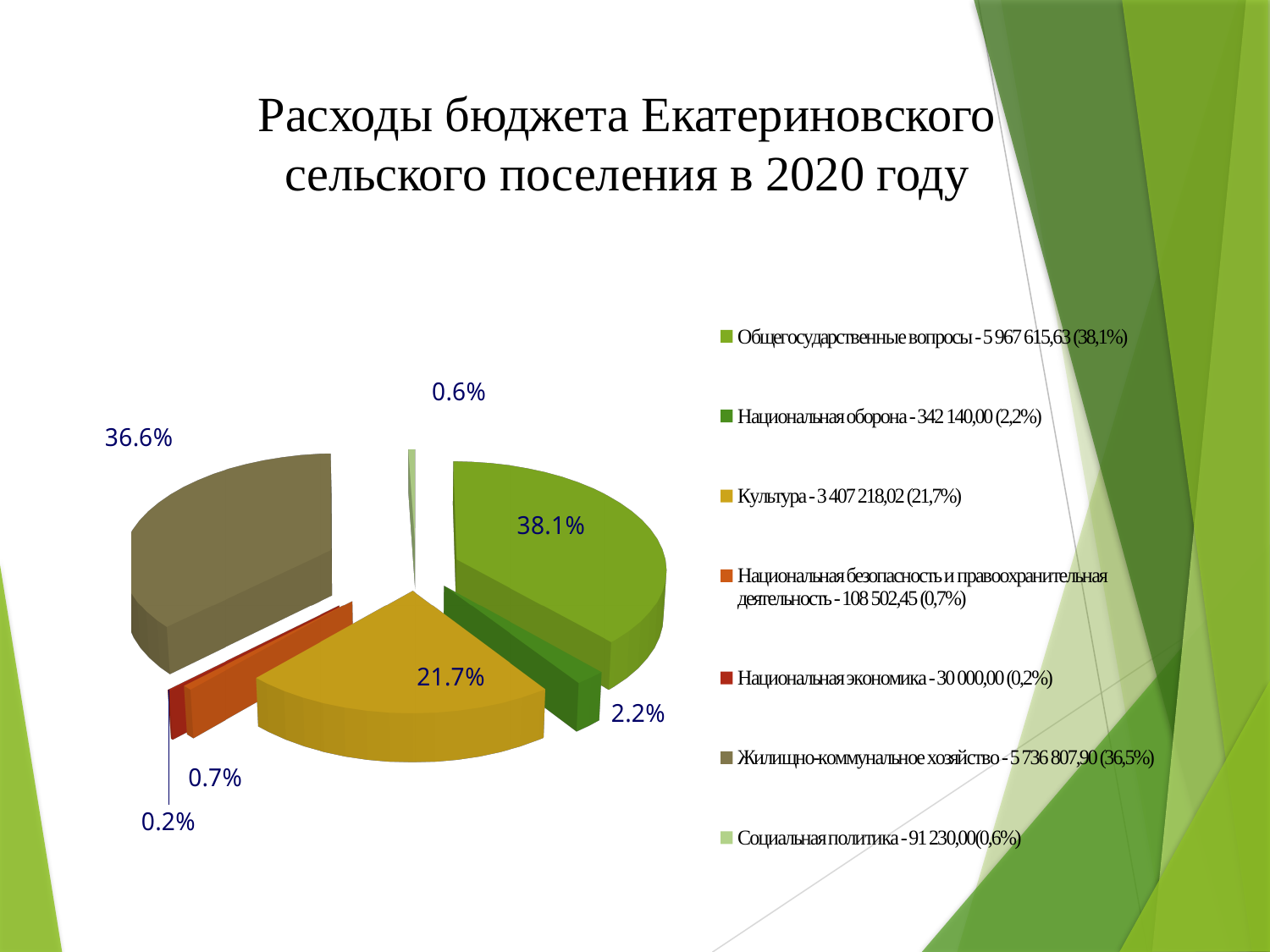
According to the legend, what is the amount for Жилищно-коммунальное хозяйство? 5 736 807,90 How many slices does the pie chart have? 7 What kind of chart is shown on the slide? Pie chart Which category has the smallest slice of the pie? Национальная экономика What is the difference in percentage points between the Общегосударственные вопросы slice (38.1%) and the Культура slice (21.7%)? 16.4 What share of the pie does Культура take? 21.7% Which category has the largest slice of the pie? Общегосударственные вопросы What is the title of the slide? Расходы бюджета Екатериновского сельского поселения в 2020 году How many entries does the legend list? 7 Which is larger: the slice for Культура or the slice for Национальная оборона? Культура What share of the pie does Национальная оборона take? 2.2% What share of the pie does Общегосударственные вопросы take? 38.1%